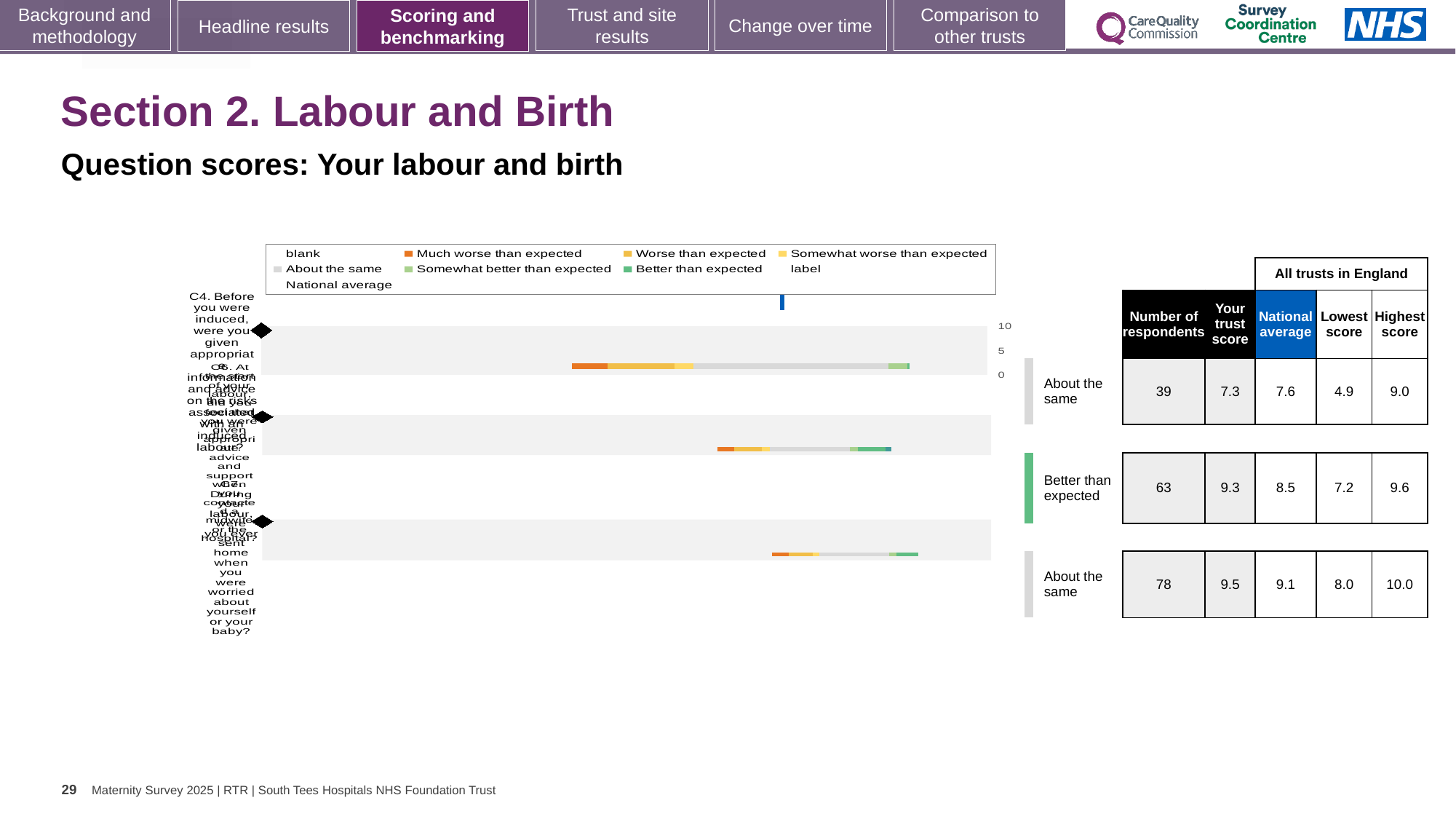
In the table beside the chart, what is the number of respondents for the first row? 39 In the table beside the chart, for the first row, which is larger: the trust score or the national average? the national average (7.6) What kind of chart is shown on the slide? bar chart In the table beside the chart, what is the national average for the first row? 7.6 In the table beside the chart, which row has the highest number of respondents? the third row (78) How many bars are plotted in the chart? 3 In the table beside the chart, what is the 'Your trust score' for the second row? 9.3 In the table beside the chart, what is the difference between the highest score and the lowest score in the second row? 2.4 In the table beside the chart, what is the highest score for the third row? 10.0 What colour represents 'Much worse than expected' in the chart legend? orange What colour represents 'Better than expected' in the chart legend? green In the table beside the chart, for the second row, which is larger: the trust score or the national average? the trust score (9.3)